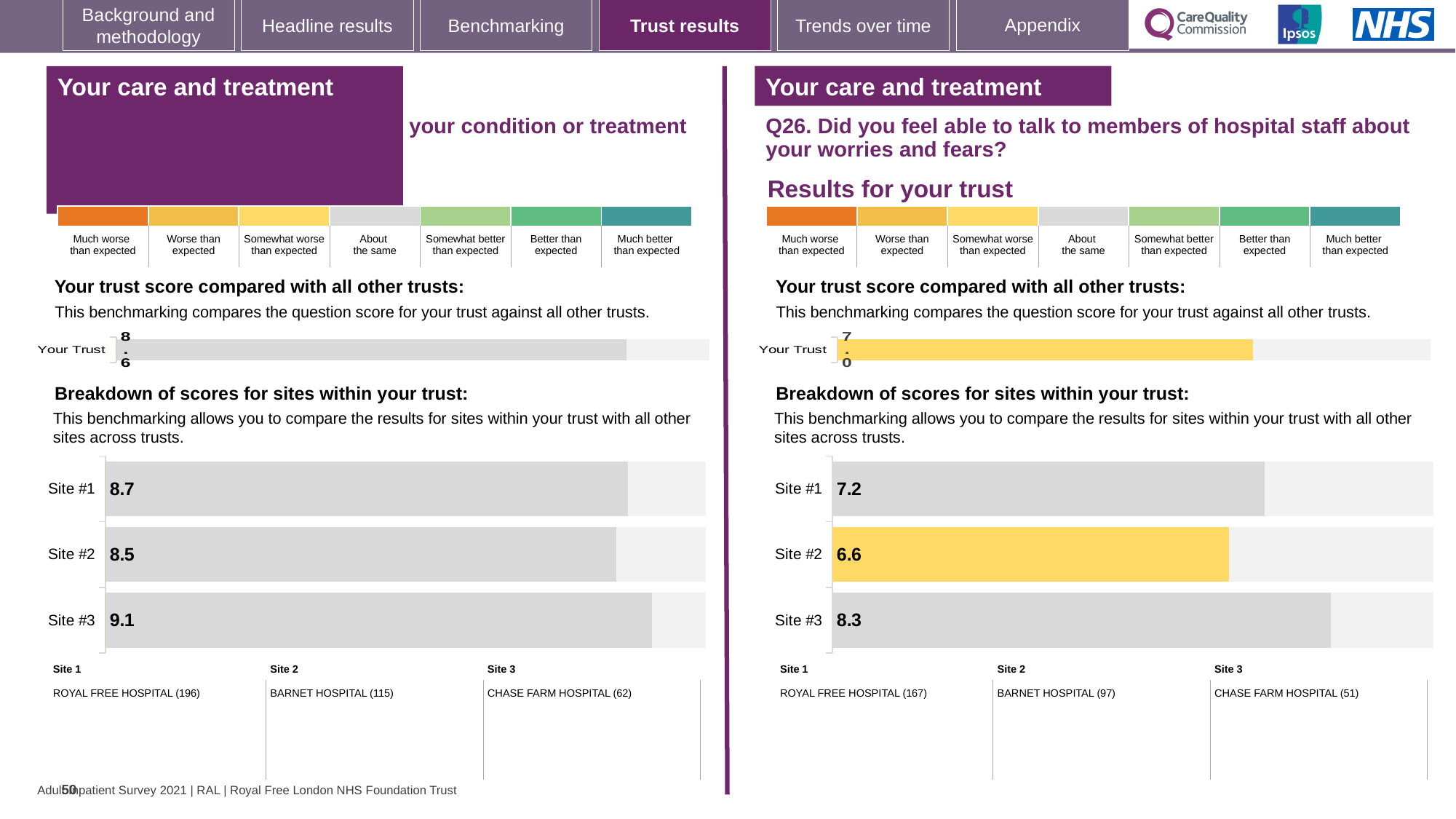
On the right-hand (Q26) 'Your Trust' chart, what is the trust score shown? 7.0 What kind of chart is the right-hand (Q26) site breakdown chart? Bar chart On the left-hand site breakdown chart, which site has the lowest score? Site #2 On the right-hand (Q26) site breakdown chart, what is the score for Site #2? 6.6 On the right-hand (Q26) site breakdown chart, what is the difference between the scores for Site #3 and Site #2? 1.7 On the left-hand site breakdown chart, what is the score for Site #3? 9.1 On the right-hand (Q26) site breakdown chart, which site's bar is coloured yellow? Site #2 How many sites are shown on the left-hand site breakdown chart? 3 On the right-hand (Q26) site breakdown chart, which has the larger score, Site #1 or Site #2? Site #1 On the right-hand (Q26) site breakdown chart, which site has the highest score? Site #3 On the left-hand 'Your Trust' chart, what is the trust score shown? 8.6 On the left-hand site breakdown chart, what is the difference between the scores for Site #3 and Site #1? 0.4